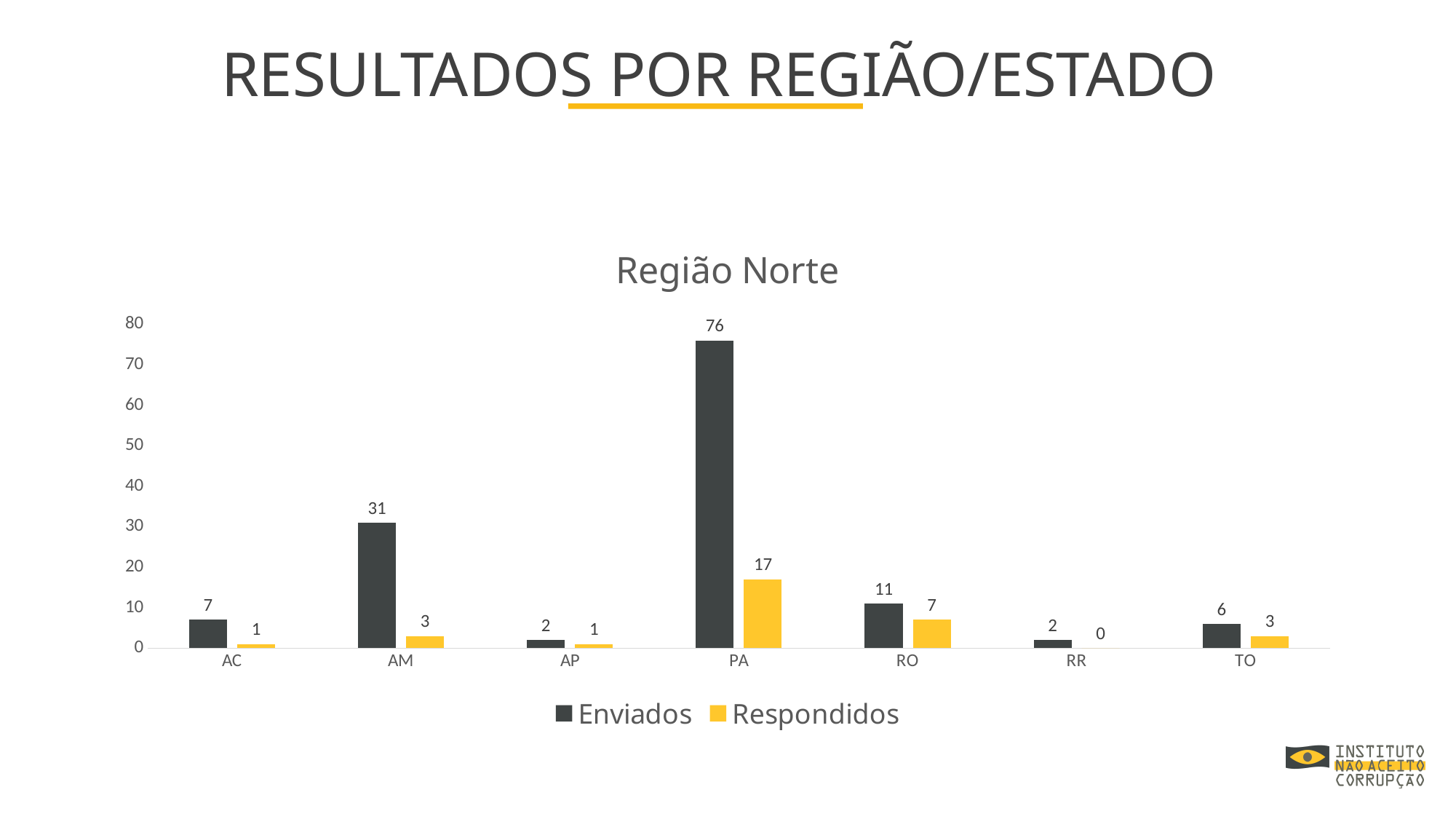
What is the difference between the Enviados values for AM and RO? 20 What is the Respondidos value for RR? 0 What is the difference between Enviados and Respondidos for PA? 59 Which is larger, the Enviados value for AC or the Enviados value for TO? AC Which state has the highest Enviados value? PA What is the Respondidos value for AM? 3 What type of chart is shown? bar chart Which state has the lowest Respondidos value? RR What is the Enviados value for PA? 76 How many series does the legend list? 2 Is the Enviados value for AM greater or less than 20? greater How many states are shown on the x axis? 7